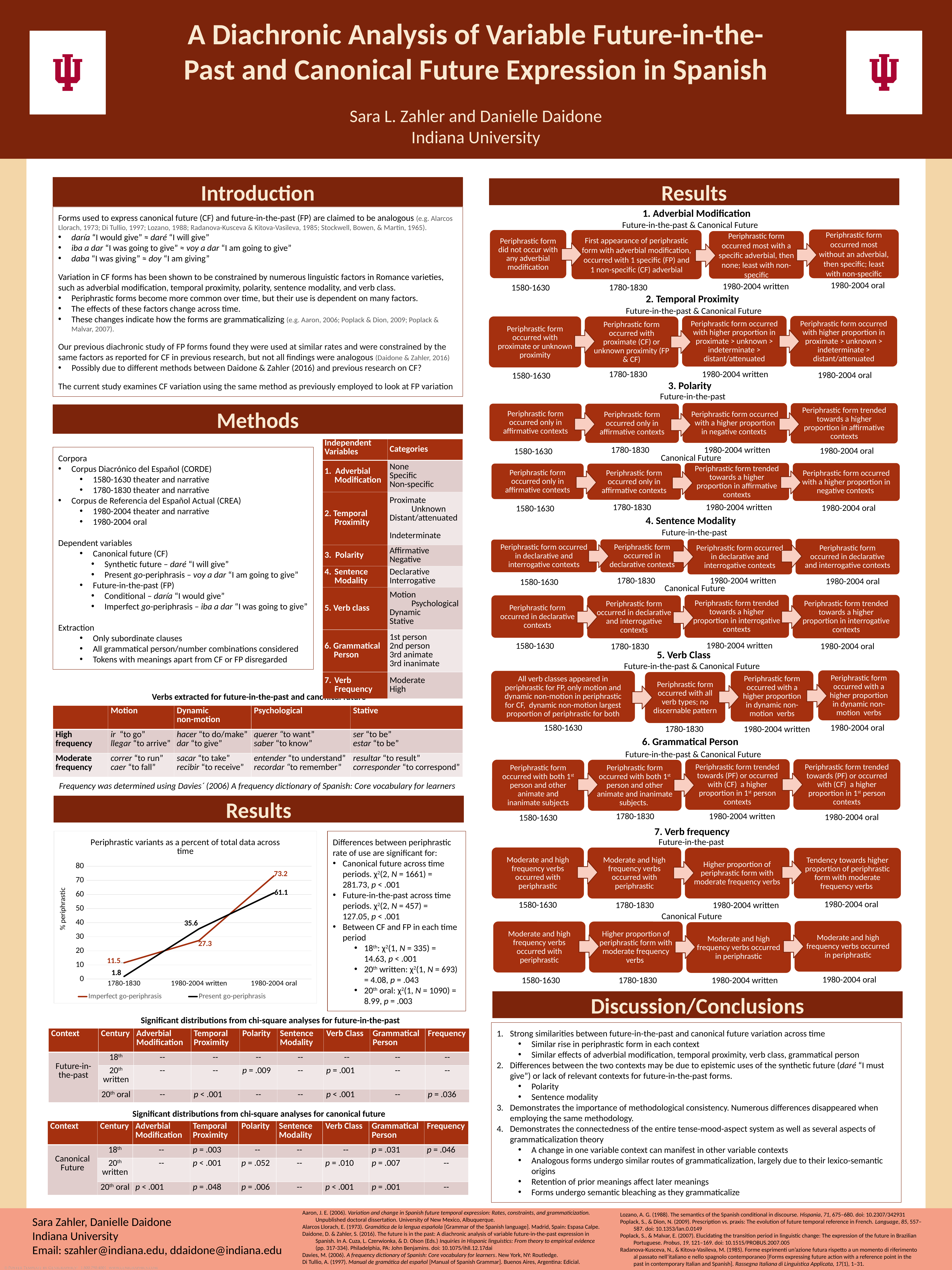
What is the value for Imperfect go-periphrasis in the 1980-2004 written period? 27.3 What is the value for Present go-periphrasis in the 1780-1830 period? 1.8 In which period is the Present go-periphrasis value lowest? 1780-1830 What is the value for Present go-periphrasis in the 1980-2004 written period? 35.6 Which series has the larger value in the 1980-2004 written period, Imperfect go-periphrasis or Present go-periphrasis? Present go-periphrasis How many time periods are shown on the x axis of the chart? 3 What kind of chart is used to show periphrastic variants as a percent of total data across time? line chart How many series does the chart legend list? 2 Do the Present go-periphrasis values rise or fall across the time periods on the x axis? rise What is the difference between the Imperfect go-periphrasis and Present go-periphrasis values in the 1980-2004 oral period? 12.1 What is the value for Imperfect go-periphrasis in the 1980-2004 oral period? 73.2 In which period is the Imperfect go-periphrasis value highest? 1980-2004 oral